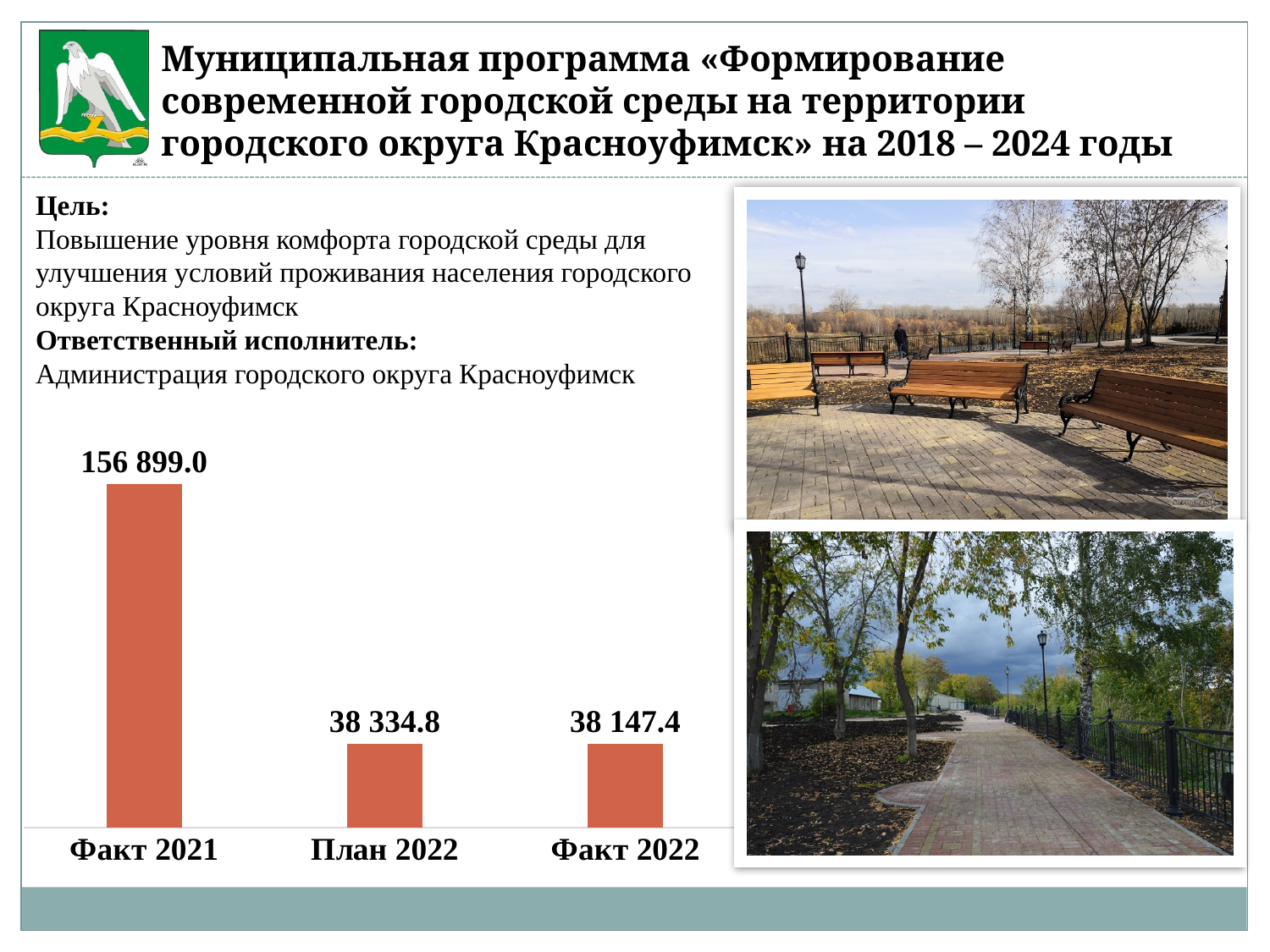
Which category has the lowest value? Факт 2022 What is the value for Факт 2022? 38 147.4 What is the difference between Факт 2021 and План 2022? 118 564.2 What is the difference between План 2022 and Факт 2022? 187.4 What is the difference between Факт 2021 and Факт 2022? 118 751.6 How many categories are shown in the chart? 3 Which is larger, План 2022 or Факт 2022? План 2022 What kind of chart is shown on the slide? Bar chart What is the value for План 2022? 38 334.8 Do the values rise or fall from Факт 2021 to Факт 2022? Fall Which category has the highest value? Факт 2021 What is the value for Факт 2021? 156 899.0